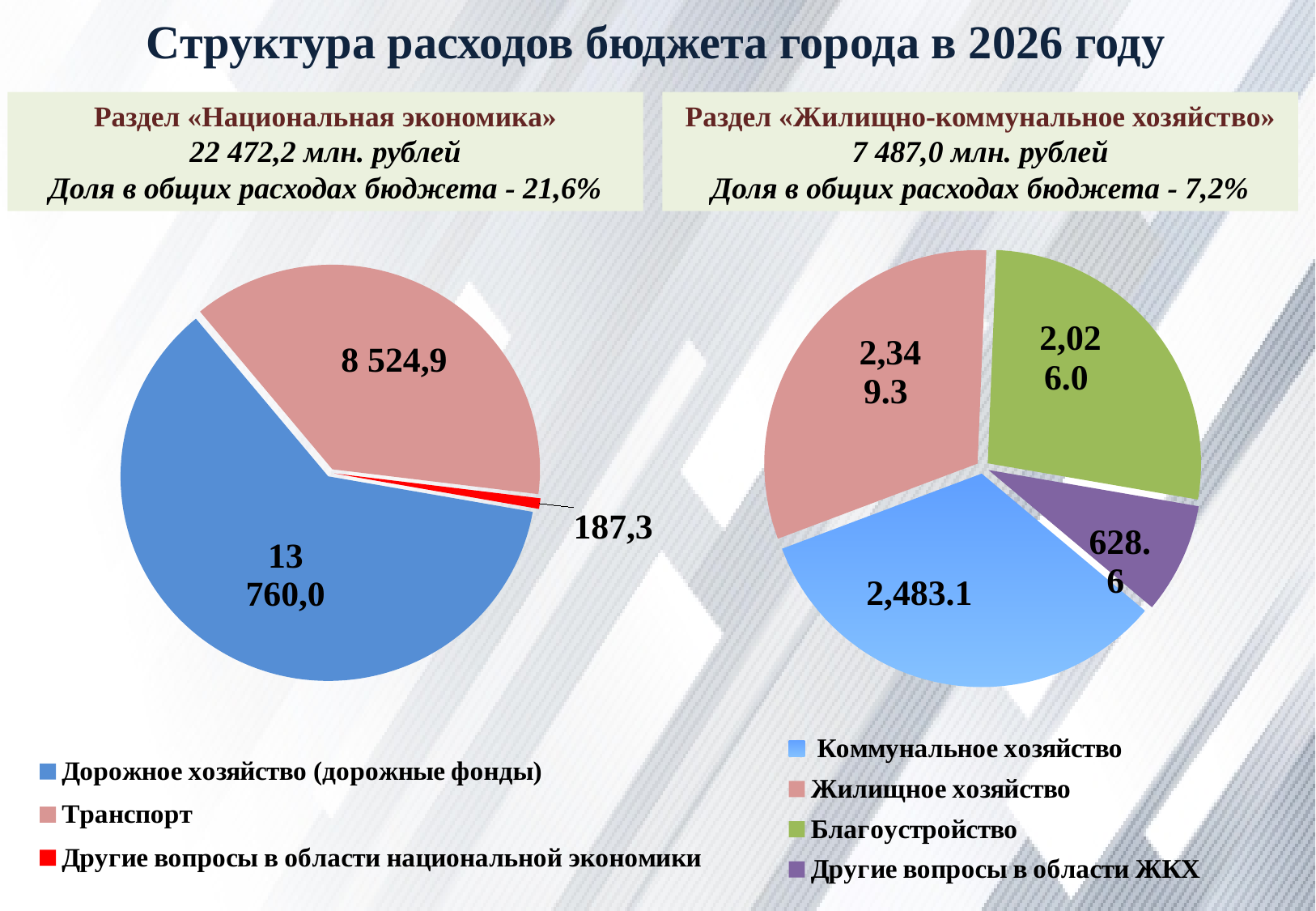
In the pie chart for «Жилищно-коммунальное хозяйство» (right), which is larger: Коммунальное хозяйство or Жилищное хозяйство? Коммунальное хозяйство In the pie chart for «Жилищно-коммунальное хозяйство» (right), what colour is the slice for Благоустройство? Green In the pie chart for «Национальная экономика» (left), what is the value for Дорожное хозяйство (дорожные фонды)? 13 760,0 How many entries does the legend of the left chart («Национальная экономика») list? 3 How many slices does the pie chart for «Жилищно-коммунальное хозяйство» (right) have? 4 In the pie chart for «Жилищно-коммунальное хозяйство» (right), which category has the largest value? Коммунальное хозяйство What type of chart is used on the left for «Национальная экономика»? Pie chart In the pie chart for «Национальная экономика» (left), what is the difference between Дорожное хозяйство (дорожные фонды) and Транспорт? 5 235,1 In the pie chart for «Национальная экономика» (left), what is the value for Транспорт? 8 524,9 In the pie chart for «Жилищно-коммунальное хозяйство» (right), what is the value for Благоустройство? 2,026.0 In the pie chart for «Жилищно-коммунальное хозяйство» (right), which category has the smallest value? Другие вопросы в области ЖКХ In the pie chart for «Национальная экономика» (left), what is the value for Другие вопросы в области национальной экономики? 187,3